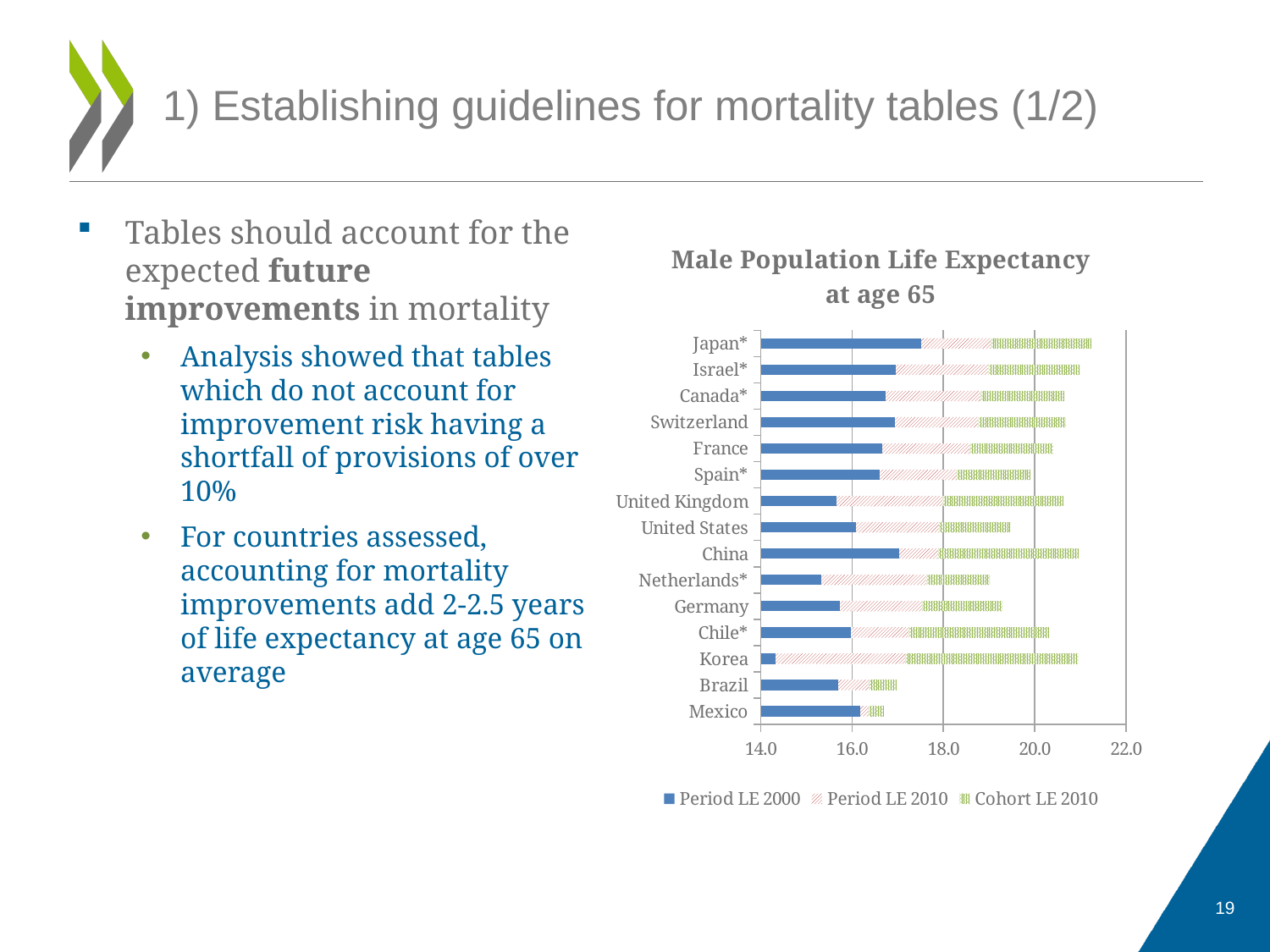
Which has the larger Period LE 2000 value, Japan* or Korea? Japan* How many series does the chart's legend list? 3 Which series are listed in the chart's legend? Period LE 2000, Period LE 2010, Cohort LE 2010 Is the Cohort LE 2010 value for Mexico greater or less than 18.0? less Is the Period LE 2000 value for Korea greater or less than 16.0? less What is the title of the chart? Male Population Life Expectancy at age 65 Is the Period LE 2000 value for Japan* greater or less than 16.0? greater Which has the larger Cohort LE 2010 value, Korea or Brazil? Korea What type of chart is shown on the slide? Bar chart How many countries are shown on the chart? 15 Which country has the lowest Period LE 2000 value? Korea